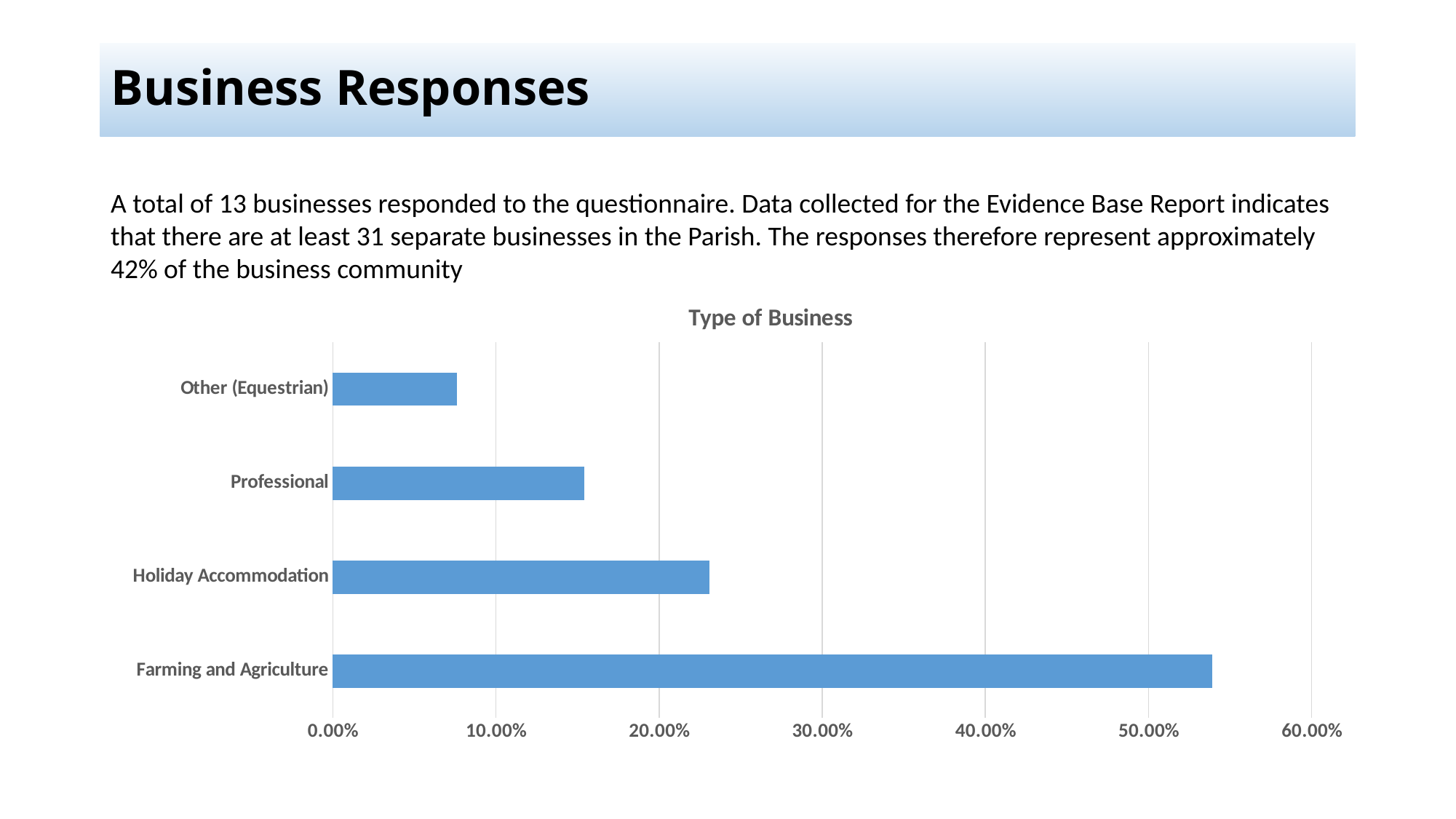
Which business type has the highest value? Farming and Agriculture Is the value for Professional greater or less than 20.00%? less What is the title of the chart? Type of Business Is the value for Farming and Agriculture greater or less than 50.00%? greater Which is larger, the value for Professional or the value for Other (Equestrian)? Professional Which is larger, the value for Holiday Accommodation or the value for Professional? Holiday Accommodation Is the value for Other (Equestrian) greater or less than 10.00%? less What is the maximum value shown on the horizontal axis? 60.00% Which business type has the lowest value? Other (Equestrian) What kind of chart is shown on the slide? bar chart How many business types are shown in the chart? 4